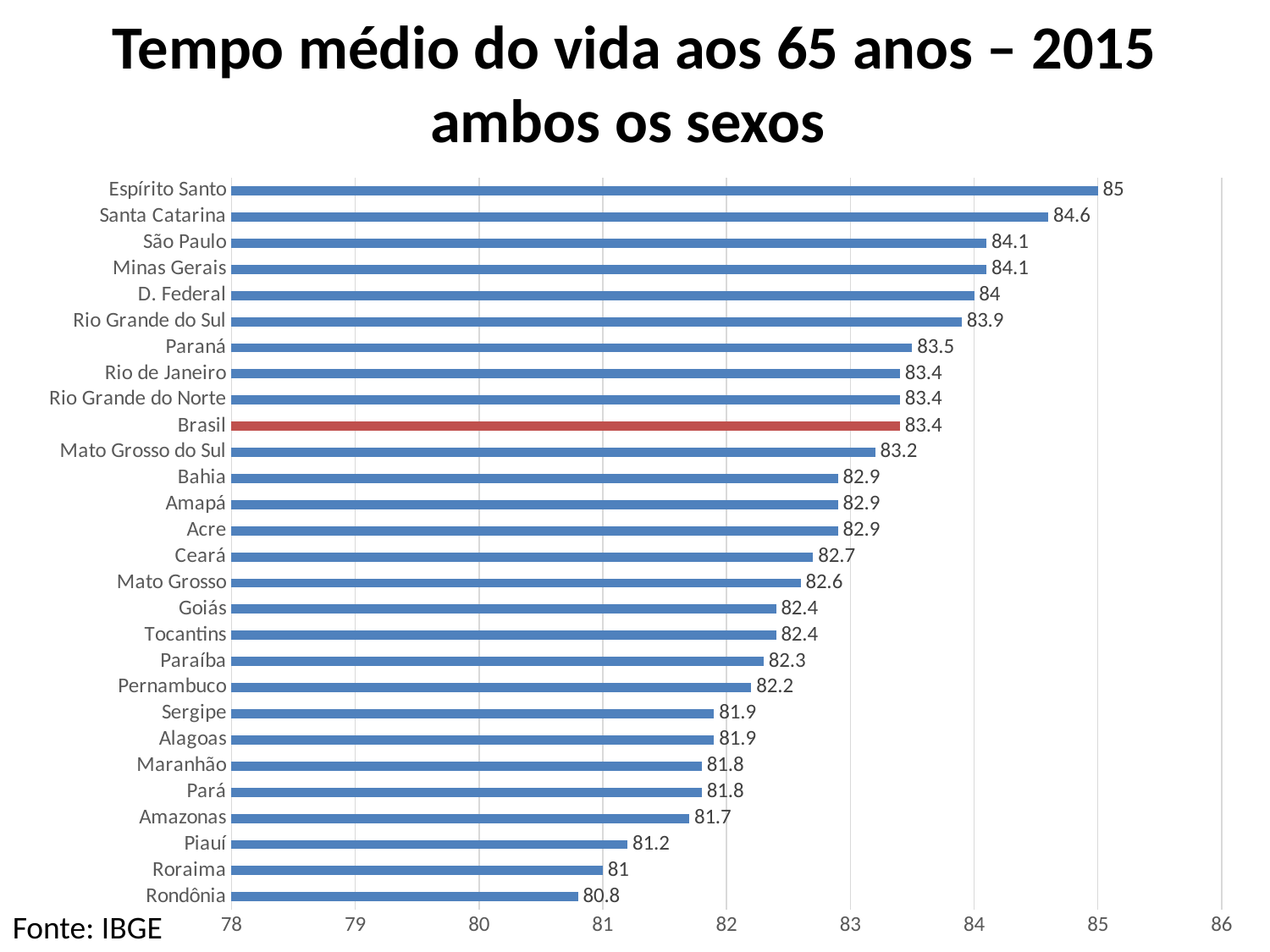
Which category has the highest value? Espírito Santo What kind of chart is this? Bar chart Is the value for D. Federal greater or less than 83? greater Which bar is shown in a different colour (red) from the others? Brasil What is the value for Rondônia? 80.8 Which category has the lowest value? Rondônia What is the value for Brasil? 83.4 Which has a larger value, Paraná or Piauí? Paraná What is the difference between the values for Santa Catarina and Brasil? 1.2 What is the value for Santa Catarina? 84.6 What is the difference between the values for Espírito Santo and Rondônia? 4.2 How many categories are shown in the chart? 28